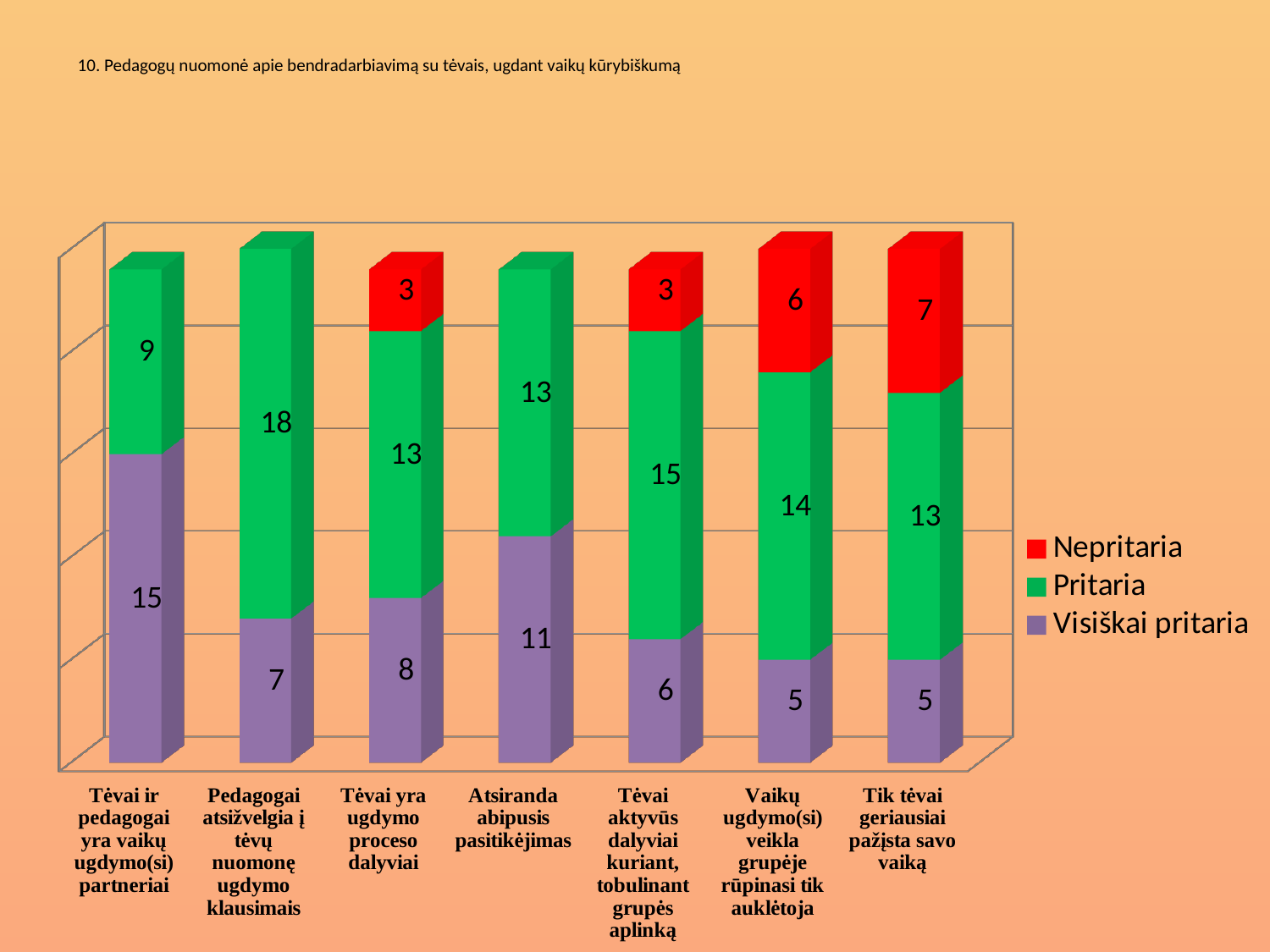
What is the 'Visiškai pritaria' value for 'Tėvai ir pedagogai yra vaikų ugdymo(si) partneriai'? 15 How many categories are shown on the x axis? 7 What type of chart is shown on the slide? stacked bar chart What is the 'Nepritaria' value for 'Tik tėvai geriausiai pažįsta savo vaiką'? 7 What is the difference between the 'Pritaria' values for 'Tėvai aktyvūs dalyviai kuriant, tobulinant grupės aplinką' and 'Vaikų ugdymo(si) veikla grupėje rūpinasi tik auklėtoja'? 1 Which category has the highest 'Visiškai pritaria' value? Tėvai ir pedagogai yra vaikų ugdymo(si) partneriai What is the total of the stacked bar for 'Tėvai yra ugdymo proceso dalyviai'? 24 Which category has the highest 'Nepritaria' value? Tik tėvai geriausiai pažįsta savo vaiką Which colour represents the 'Nepritaria' series in the legend? red How many series does the legend list? 3 Which is larger: the 'Visiškai pritaria' value for 'Atsiranda abipusis pasitikėjimas' or for 'Tėvai yra ugdymo proceso dalyviai'? Atsiranda abipusis pasitikėjimas What is the 'Pritaria' value for 'Pedagogai atsižvelgia į tėvų nuomonę ugdymo klausimais'? 18